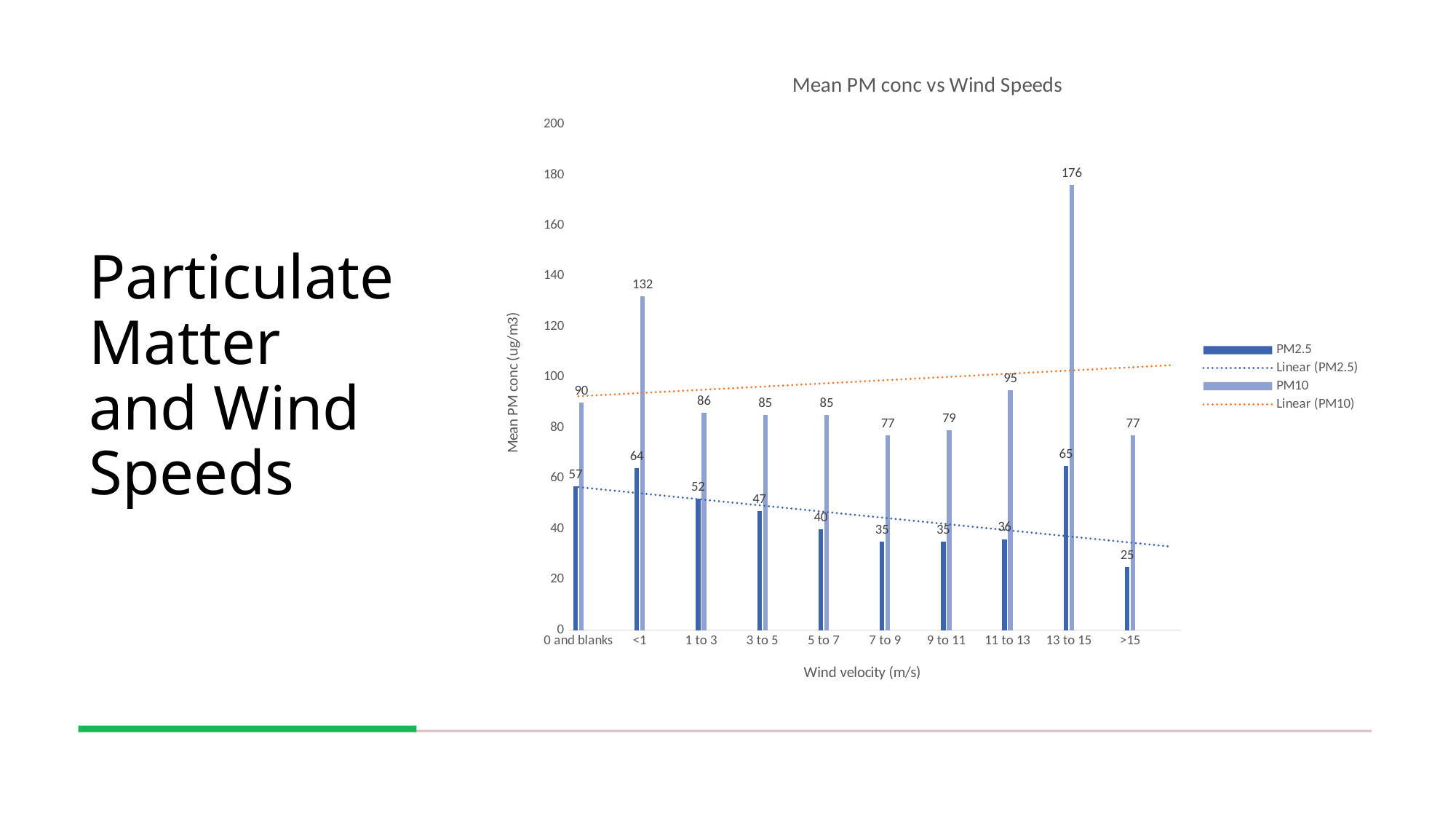
How many entries does the legend list? 4 What is the PM2.5 value for the <1 wind velocity category? 64 What is the PM10 value for the 0 and blanks category? 90 What is the difference between the PM10 and PM2.5 values for the <1 category? 68 Is the PM10 value for 11 to 13 greater or less than 80? greater Which wind velocity category has the lowest PM2.5 value? >15 Which wind velocity category has the highest PM10 value? 13 to 15 Does the Linear (PM2.5) trend line rise or fall from left to right? Fall Which is larger, the PM2.5 value for 13 to 15 or the PM2.5 value for 0 and blanks? 13 to 15 What is the PM10 value for the 13 to 15 wind velocity category? 176 How many wind velocity categories are shown on the x axis? 10 What kind of chart is shown on the slide? Bar chart